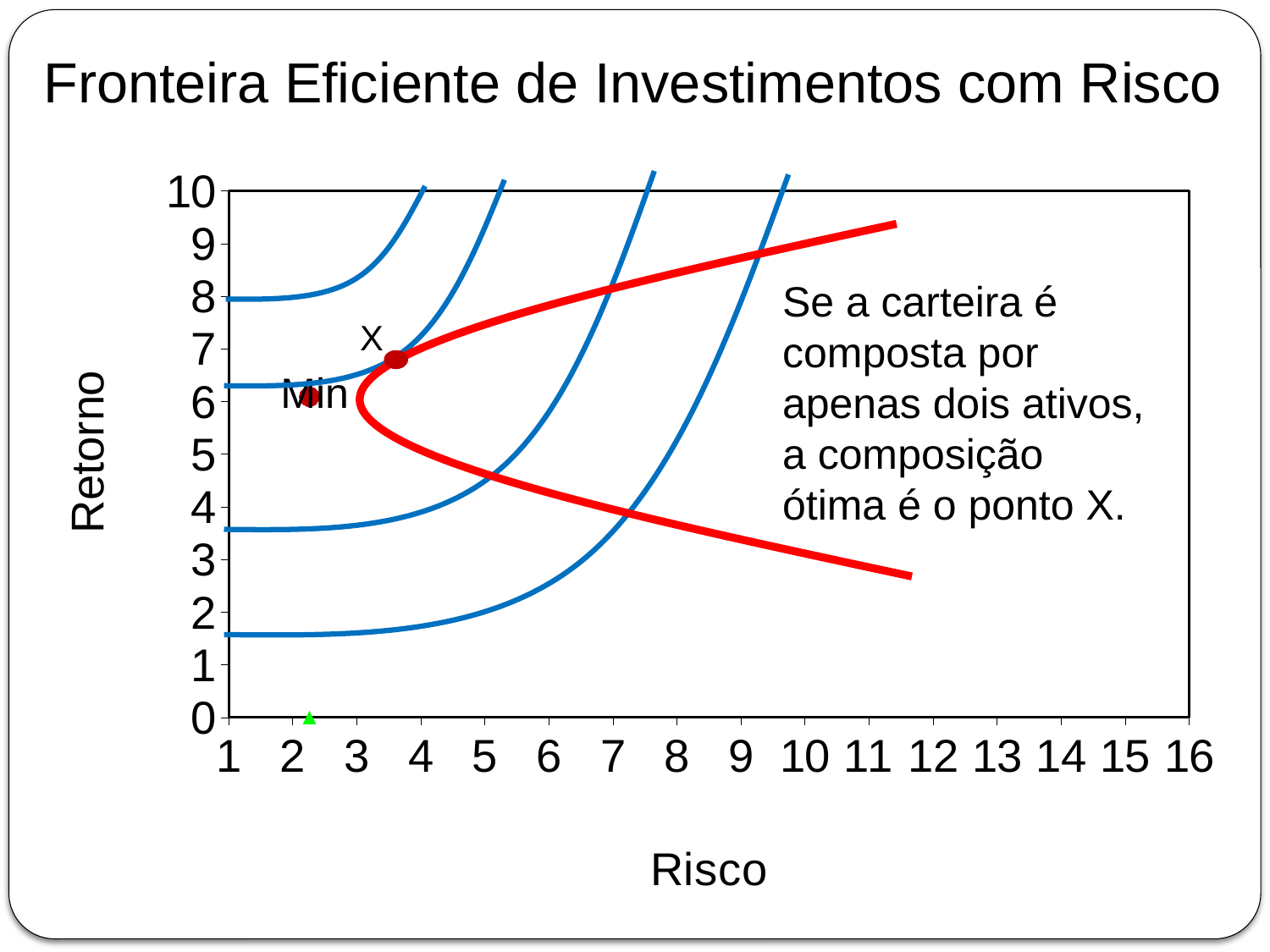
What is the highest value shown on the Risco axis? 16 Is the Retorno value at the point labeled Min greater or less than 8? less Is the Risco value at point X greater or less than 5? less How many blue curves are drawn on the chart? 4 What is the label of the horizontal axis? Risco Is the Retorno value at point X greater or less than 9? less Along the lower branch of the red curve, does Retorno rise or fall as Risco increases? fall What is the title of the chart? Fronteira Eficiente de Investimentos com Risco Which of the two labeled points, X or Min, has the higher Retorno? X Along the upper branch of the red curve, does Retorno rise or fall as Risco increases? rise What kind of chart is shown on the slide? line chart